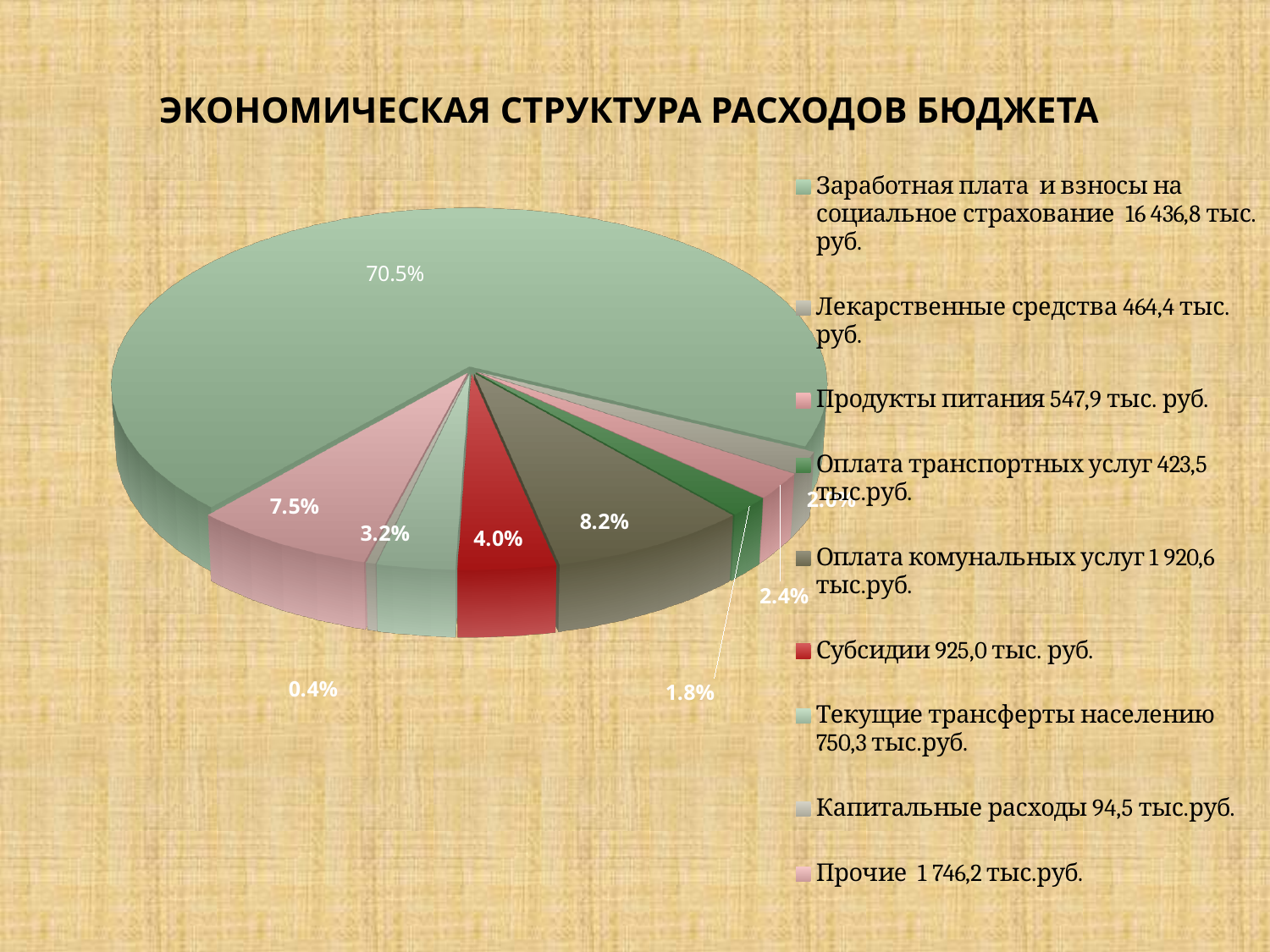
What percentage is shown for the Оплата комунальных услуг slice? 8.2% How many categories does the legend list? 9 What kind of chart is shown on the slide? Pie chart What is the difference between the Прочие share (7.5%) and the Субсидии share (4.0%)? 3.5% Which category has the largest share of the pie? Заработная плата и взносы на социальное страхование What percentage is shown for the Субсидии slice? 4.0% Which category has the smallest share of the pie? Капитальные расходы What is the title of the chart? ЭКОНОМИЧЕСКАЯ СТРУКТУРА РАСХОДОВ БЮДЖЕТА What share of the pie is labelled for the largest slice (Заработная плата и взносы на социальное страхование)? 70.5% What percentage is shown for the Прочие slice? 7.5% Which is larger: the share for Оплата комунальных услуг or the share for Прочие? Оплата комунальных услуг What amount does the legend give for Субсидии? 925,0 тыс. руб.